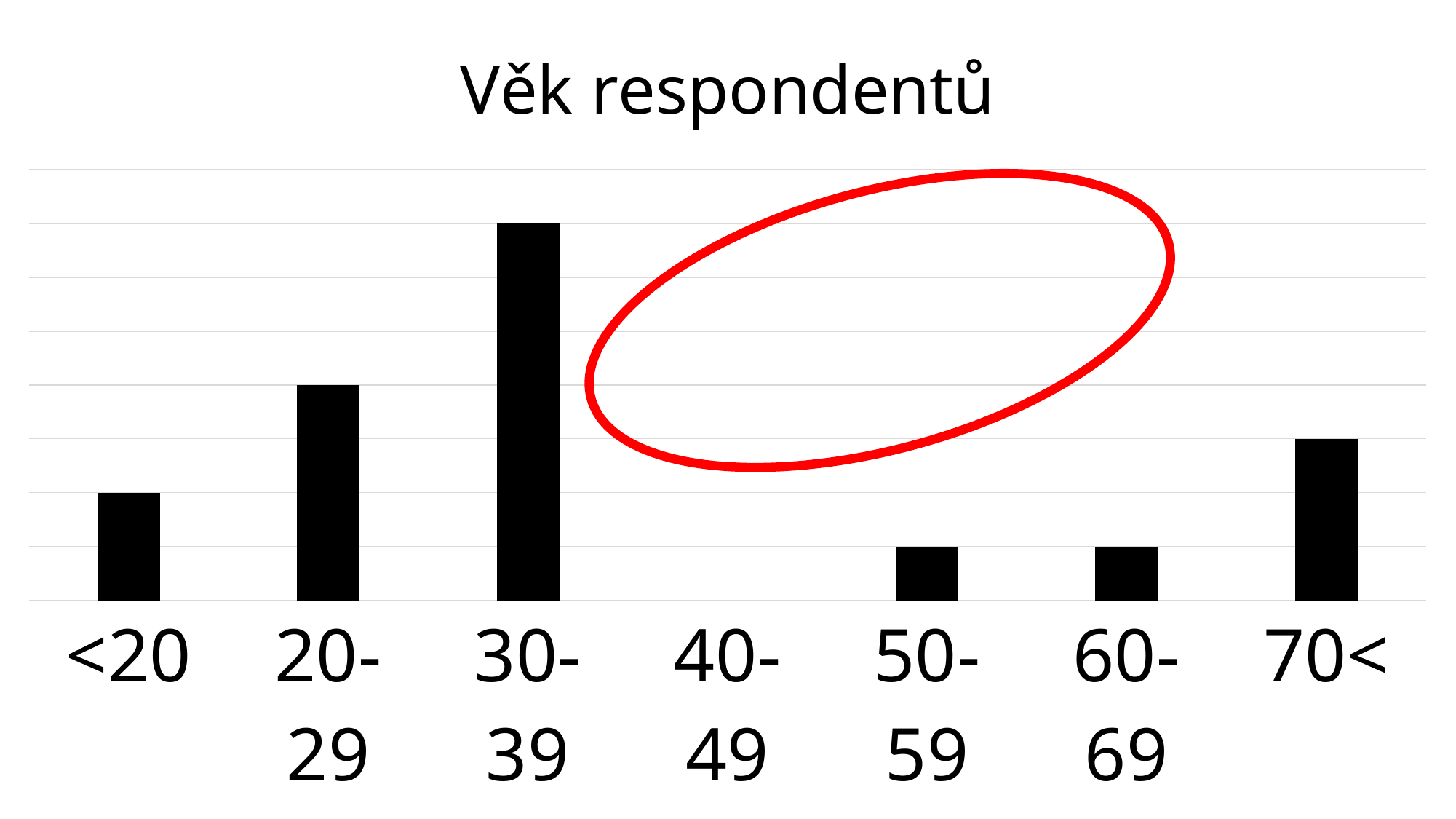
Which is larger, the value for <20 or the value for 60-69? <20 Which is larger, the value for 20-29 or the value for 70<? 20-29 Which age category has the highest bar? 30-39 How many age categories are shown on the x axis? 7 What is the title of the chart? Věk respondentů Which is larger, the value for 70< or the value for 50-59? 70< Which age category has the lowest value (no visible bar)? 40-49 What kind of chart is shown on the slide? bar chart Which age category is highlighted by the red ellipse on the chart? 40-49